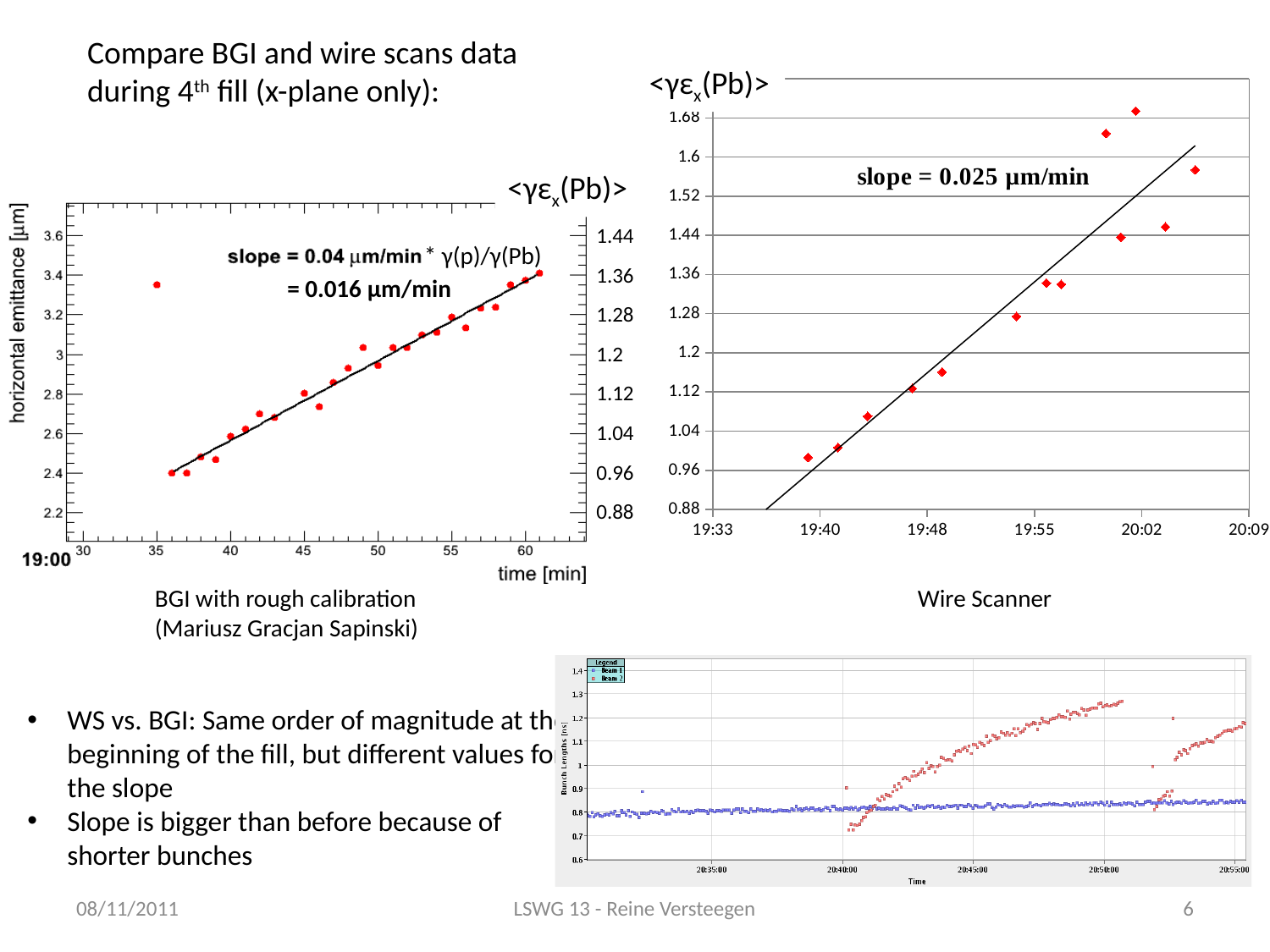
What is the difference between the Wire Scanner slope (0.025 µm/min) and the BGI converted slope (0.016 µm/min)? 0.009 µm/min In the Wire Scanner chart, is the lowest plotted point (near 19:39) greater or less than 1.04? less In the Wire Scanner chart, what slope is printed on the chart? 0.025 µm/min What kind of chart is the Wire Scanner chart on the right? scatter plot In the Wire Scanner chart, is the highest plotted point greater or less than 1.6? greater In the BGI chart on the left, what is the final slope value printed after the conversion (= ...)? 0.016 µm/min In the bottom bunch length chart, how many series does the legend list? 2 In the bottom bunch length chart, which series is higher at 20:50:00, Beam 1 or Beam 2? Beam 2 Which chart shows the larger printed slope, the BGI chart or the Wire Scanner chart? Wire Scanner In the BGI chart on the left, what is the label of the y axis? horizontal emittance [µm] In the Wire Scanner chart, do the emittance values rise or fall as time goes from 19:40 to 20:05? rise In the BGI chart on the left, is the isolated point at 35 min greater or less than 3.2? greater